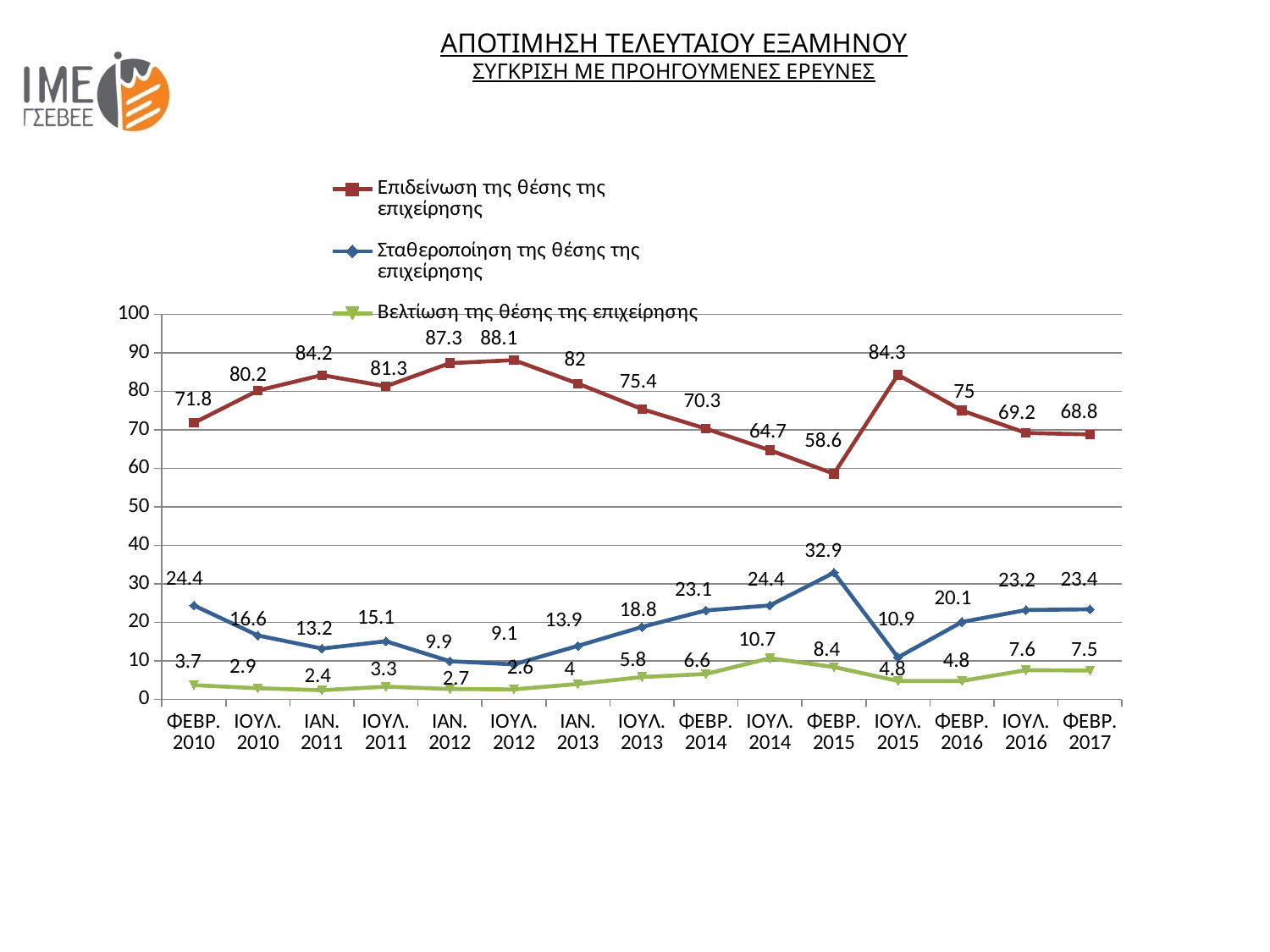
In which period is Βελτίωση της θέσης της επιχείρησης lowest? ΙΑΝ. 2011 How many time periods are shown on the x axis? 15 How many series does the legend list? 3 Which is larger: the Σταθεροποίηση value for ΦΕΒΡ. 2010 or for ΙΟΥΛ. 2010? ΦΕΒΡ. 2010 What is the value of Σταθεροποίηση της θέσης της επιχείρησης for ΦΕΒΡ. 2015? 32.9 What is the value of Βελτίωση της θέσης της επιχείρησης for ΙΟΥΛ. 2014? 10.7 What is the difference between the Επιδείνωση values for ΙΟΥΛ. 2015 and ΦΕΒΡ. 2015? 25.7 In which period is Επιδείνωση της θέσης της επιχείρησης lowest? ΦΕΒΡ. 2015 In which period is Σταθεροποίηση της θέσης της επιχείρησης highest? ΦΕΒΡ. 2015 What kind of chart is shown on the slide? Line chart What is the value of Επιδείνωση της θέσης της επιχείρησης for ΙΟΥΛ. 2012? 88.1 What is the total of the three series' values for ΦΕΒΡ. 2017? 99.7